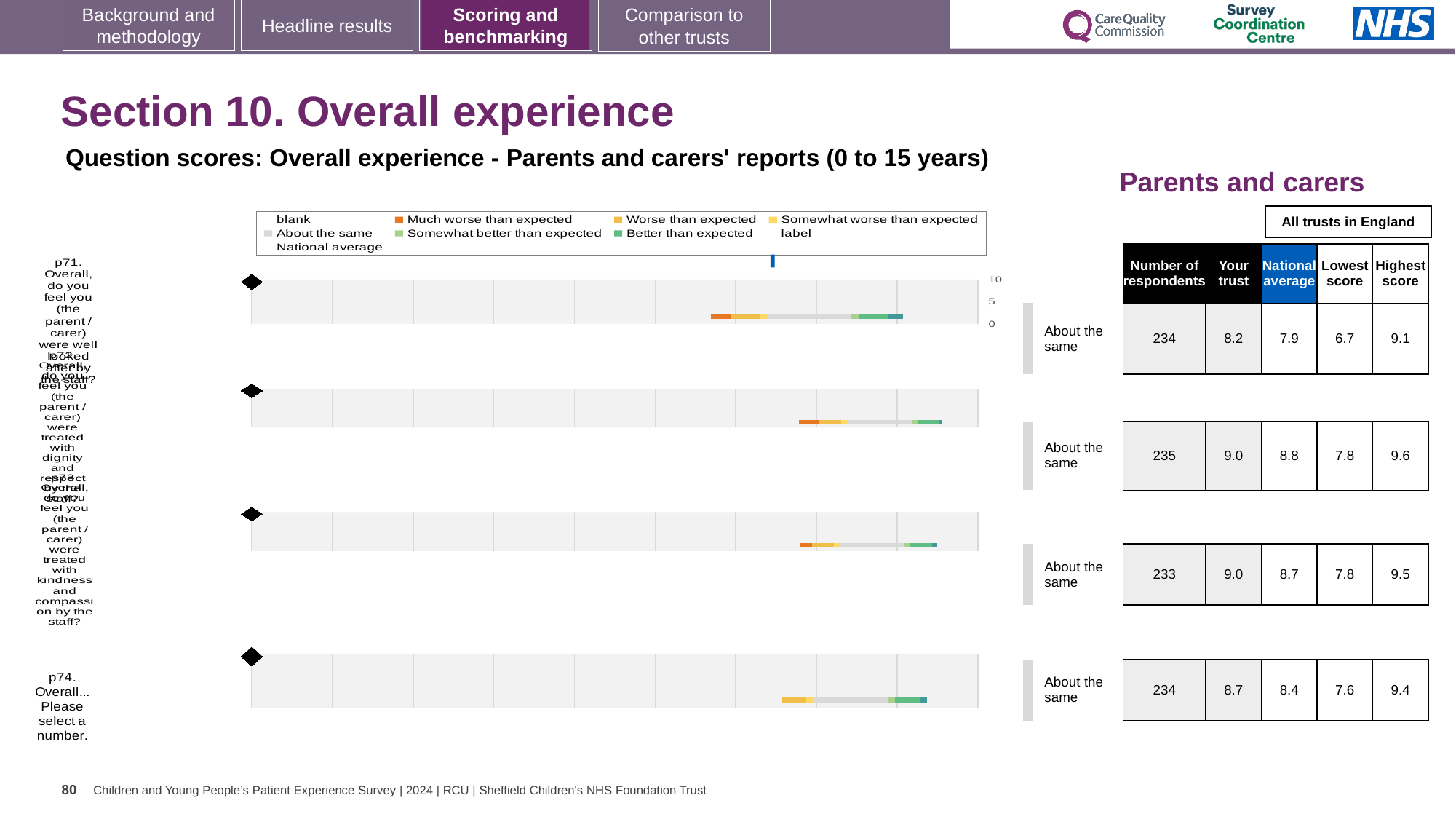
In the table beside the chart, which has the larger 'Your trust' score, p72 or p74? p72 Which colour does the legend use for 'Much worse than expected'? orange In the table beside the chart, what is the difference between the 'Your trust' score and the national average for p71? 0.3 How many entries does the chart legend list? 9 What benchmark label is shown next to each of the four bars? About the same In the table beside the chart, what is the 'Your trust' score for p71? 8.2 In the table beside the chart, what is the number of respondents for p73? 233 How many question rows (bars) are plotted in the chart? 4 In the table beside the chart, which question has the lowest 'Lowest score' value? p71 What is the title of the chart section above the bars? Question scores: Overall experience - Parents and carers' reports (0 to 15 years) In the table beside the chart, which question has the highest 'Highest score' value? p72 What kind of chart is shown on the slide? bar chart